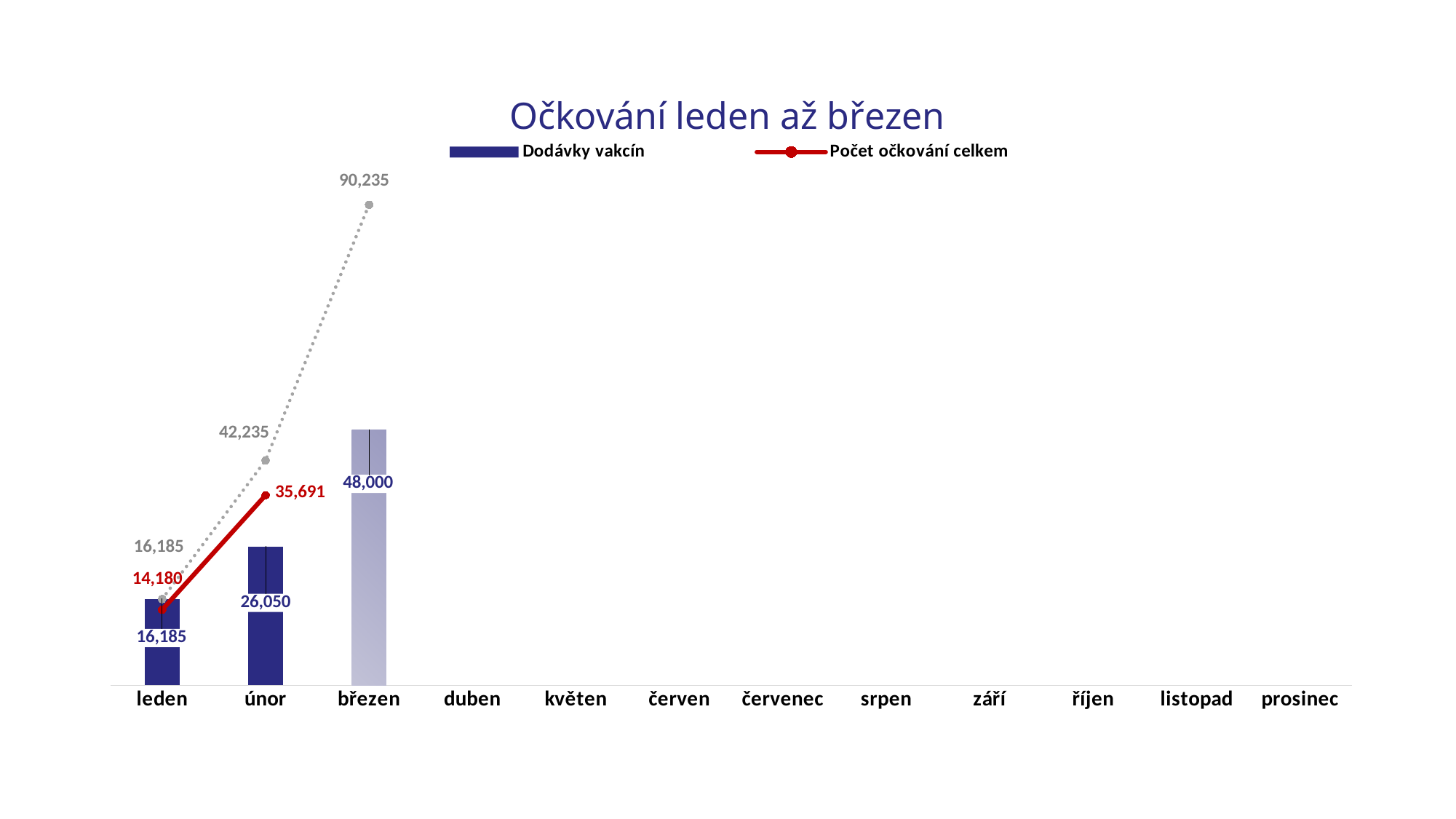
What type of chart is shown on the slide? Combined bar and line chart What is the value of Dodávky vakcín for březen? 48,000 What is the title of the chart? Očkování leden až březen What is the value of Počet očkování celkem for leden? 14,180 How many month categories are shown on the x axis? 12 Which is larger in únor: Dodávky vakcín or Počet očkování celkem? Počet očkování celkem Which month has the highest value for Dodávky vakcín? březen What is the value of Dodávky vakcín for únor? 26,050 What is the value of Počet očkování celkem for únor? 35,691 How many series does the legend list? 2 Which month has the lowest value for Dodávky vakcín? leden What is the difference between Dodávky vakcín for březen and únor? 21,950